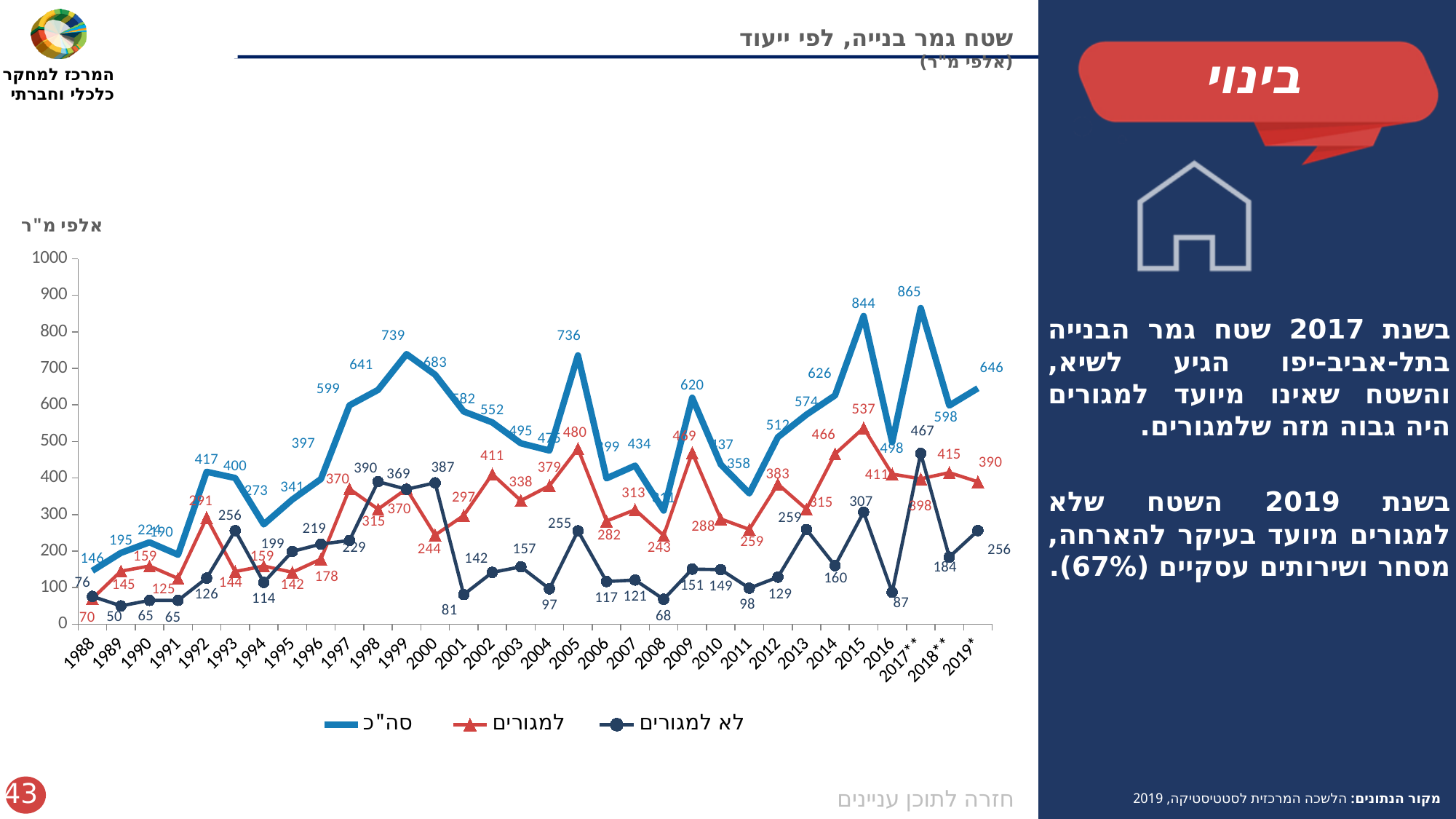
In which year does the לא למגורים series have its lowest value? 1989 What is the value of the למגורים series for 2015? 537 How many series does the legend list? 3 What type of chart is shown on the slide? Line chart What is the difference between the סה"כ values for 2017** and 2016? 367 What is the value of the סה"כ series for 2019*? 646 What is the value of the לא למגורים series for 2017**? 467 What is the title of the chart? שטח גמר בנייה, לפי ייעוד Is the סה"כ value for 1999 greater or less than 700? greater In which year does the סה"כ series reach its highest value? 2017** In 2017**, which is larger: the למגורים value or the לא למגורים value? לא למגורים How many years are shown on the x axis? 32